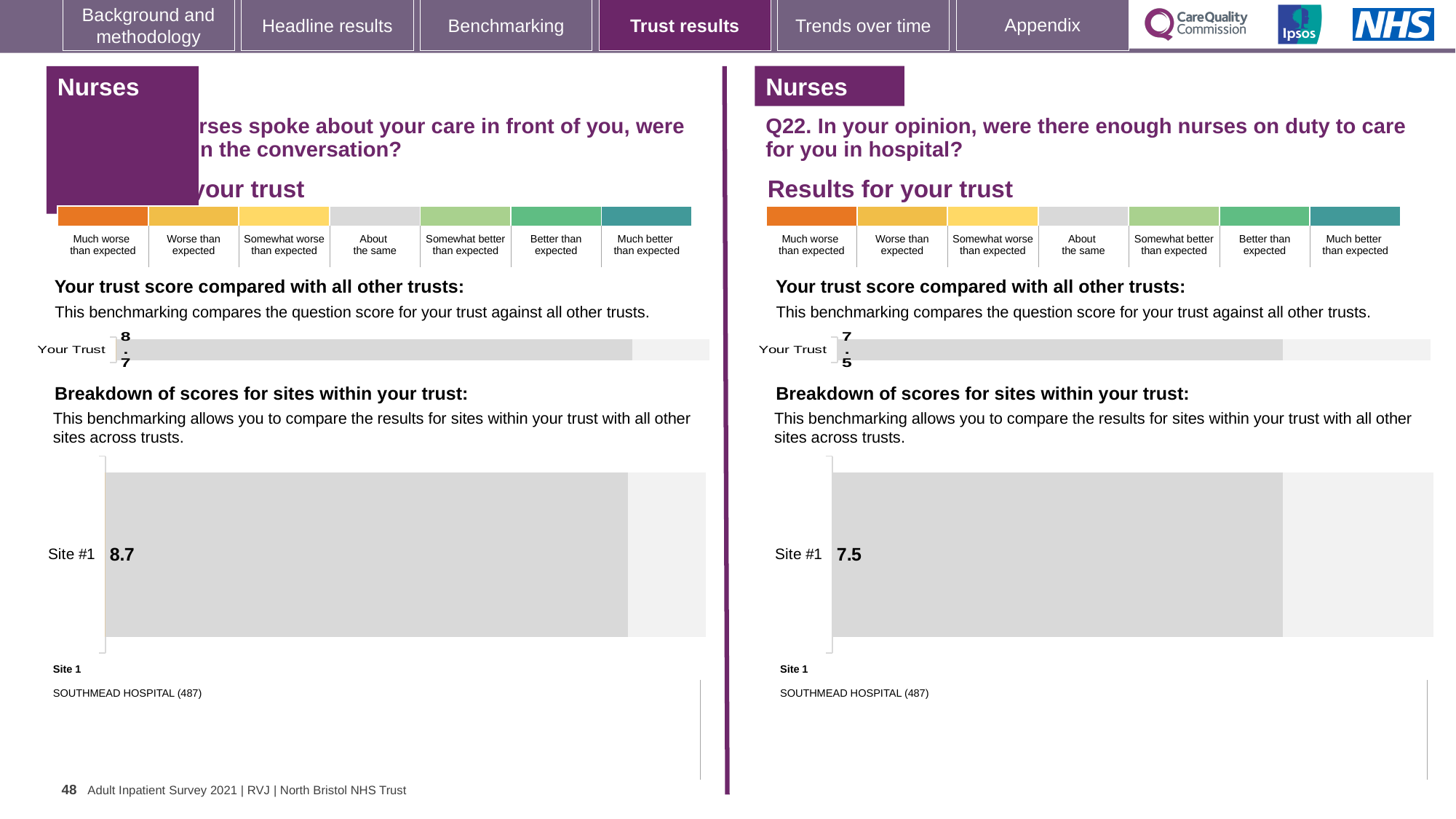
On the left half of the slide, what score is shown for Site #1 in the 'Breakdown of scores for sites within your trust' chart? 8.7 On the left half of the slide, is the Site #1 score the same as the Your Trust score? Yes, both 8.7 How many sites are shown in the 'Breakdown of scores for sites within your trust' chart on the right half of the slide (Q22)? 1 What type of chart is used to show the Site #1 score on the right half of the slide (Q22)? Bar chart What is the difference between the Your Trust score on the left half of the slide and the Your Trust score on the right half (Q22)? 1.2 What is the question text for the chart on the right half of the slide? Q22. In your opinion, were there enough nurses on duty to care for you in hospital? Which is larger: the Site #1 score on the left half of the slide or the Site #1 score on the right half (Q22)? Left half (8.7) On the right half of the slide (Q22), what score is shown for Site #1 in the 'Breakdown of scores for sites within your trust' chart? 7.5 On the right half of the slide (Q22), what is the score shown for Your Trust in the 'Your trust score compared with all other trusts' chart? 7.5 On the right half of the slide (Q22), which site name is listed as Site 1 below the breakdown chart? SOUTHMEAD HOSPITAL (487) On the left half of the slide, what is the score shown for Your Trust in the 'Your trust score compared with all other trusts' chart? 8.7